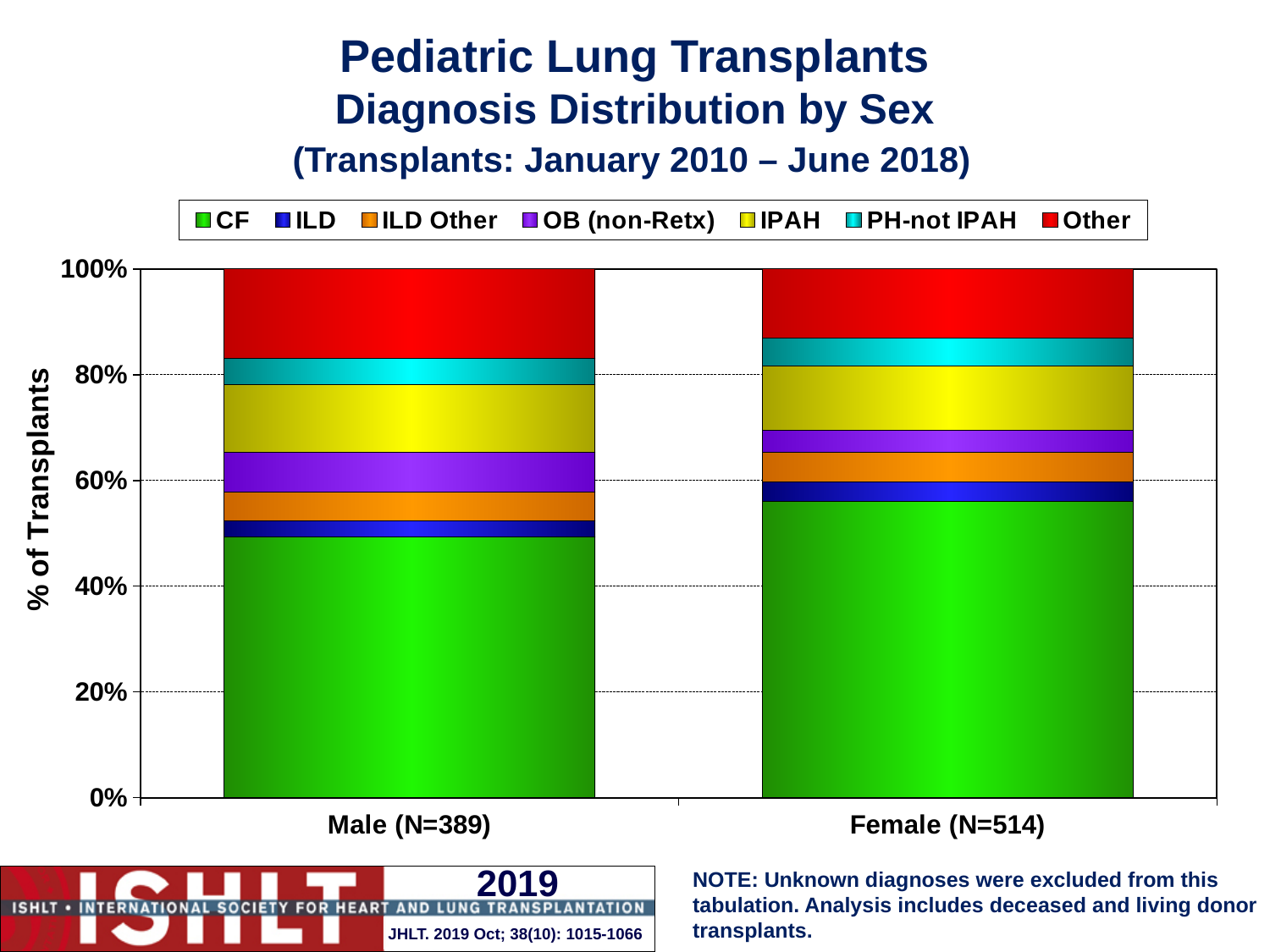
Is the CF share for Female (N=514) greater or less than 60%? less What is the N shown for the Female category? 514 Is the CF share for Male (N=389) greater or less than 60%? less Which group has the larger OB (non-Retx) share, Male (N=389) or Female (N=514)? Male (N=389) What is the label of the y axis? % of Transplants Which group has the larger CF share, Male (N=389) or Female (N=514)? Female (N=514) How many series does the legend list? 7 Is the CF share for Female (N=514) greater or less than 40%? greater How many categories (bars) are plotted on the x axis? 2 Which group has the larger Other share, Male (N=389) or Female (N=514)? Male (N=389) What kind of chart is shown on the slide? Stacked bar chart